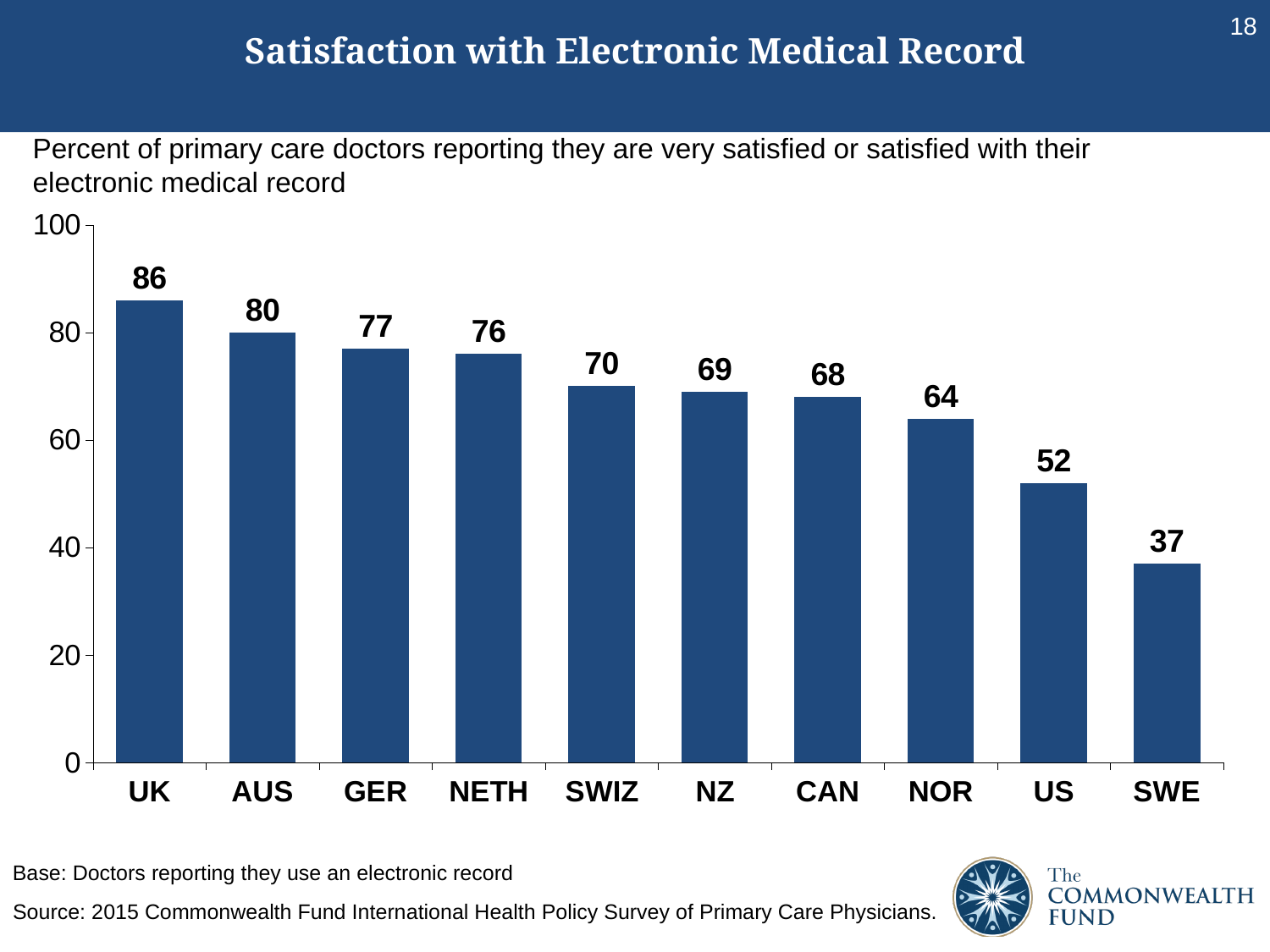
What kind of chart is shown on the slide? bar chart What is the value for the US? 52 What is the value for NETH? 76 How many countries are shown in the chart? 10 Which is larger, the value for GER or the value for NOR? GER Do the values rise or fall from left to right across the x axis? fall Which country has the lowest value? SWE What is the difference between the values for AUS and US? 28 What is the value for the UK? 86 What is the difference between the values for UK and SWE? 49 Is the value for CAN greater or less than 60? greater Which country has the highest value? UK